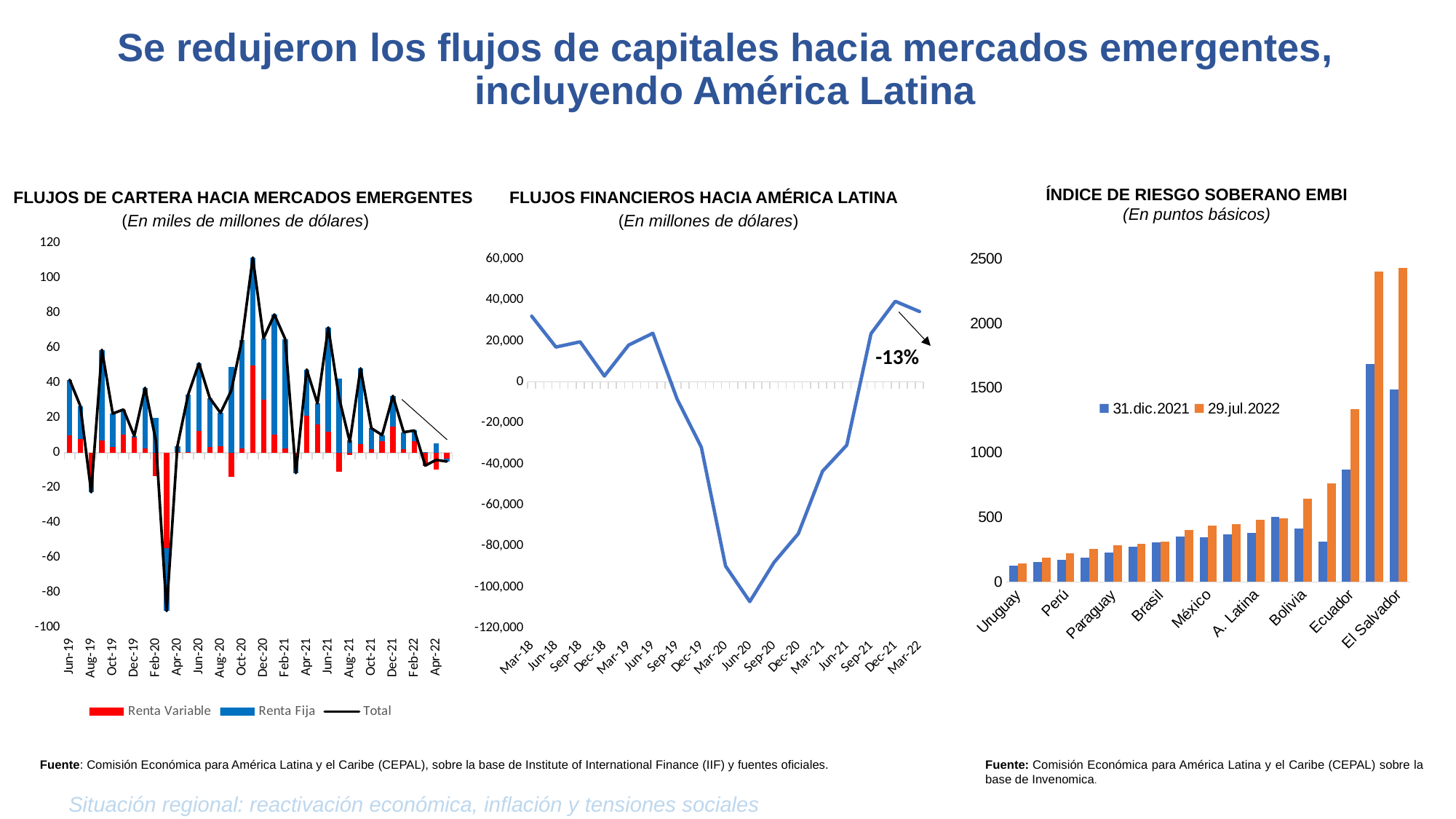
In the 'ÍNDICE DE RIESGO SOBERANO EMBI' chart, which country has the highest value? El Salvador In the 'ÍNDICE DE RIESGO SOBERANO EMBI' chart, do the values generally rise or fall from left to right along the x axis? rise In the 'ÍNDICE DE RIESGO SOBERANO EMBI' chart, is the 29.jul.2022 value for El Salvador greater or less than 2000? greater What kind of chart is the 'FLUJOS FINANCIEROS HACIA AMÉRICA LATINA' chart? line chart In the 'ÍNDICE DE RIESGO SOBERANO EMBI' chart, which is larger for El Salvador: the 31.dic.2021 value or the 29.jul.2022 value? 29.jul.2022 How many series does the legend of the 'FLUJOS DE CARTERA HACIA MERCADOS EMERGENTES' chart list? 3 In the 'ÍNDICE DE RIESGO SOBERANO EMBI' chart, which labelled country has the lowest values? Uruguay How many series does the legend of the 'ÍNDICE DE RIESGO SOBERANO EMBI' chart list? 2 How many data points are plotted in the 'FLUJOS FINANCIEROS HACIA AMÉRICA LATINA' chart? 17 In the 'FLUJOS FINANCIEROS HACIA AMÉRICA LATINA' chart, is the value for Jun-20 greater or less than -100,000? less What kind of chart is the 'ÍNDICE DE RIESGO SOBERANO EMBI' chart? bar chart In the 'FLUJOS DE CARTERA HACIA MERCADOS EMERGENTES' chart, is the Total value for Feb-20 greater or less than -80? greater